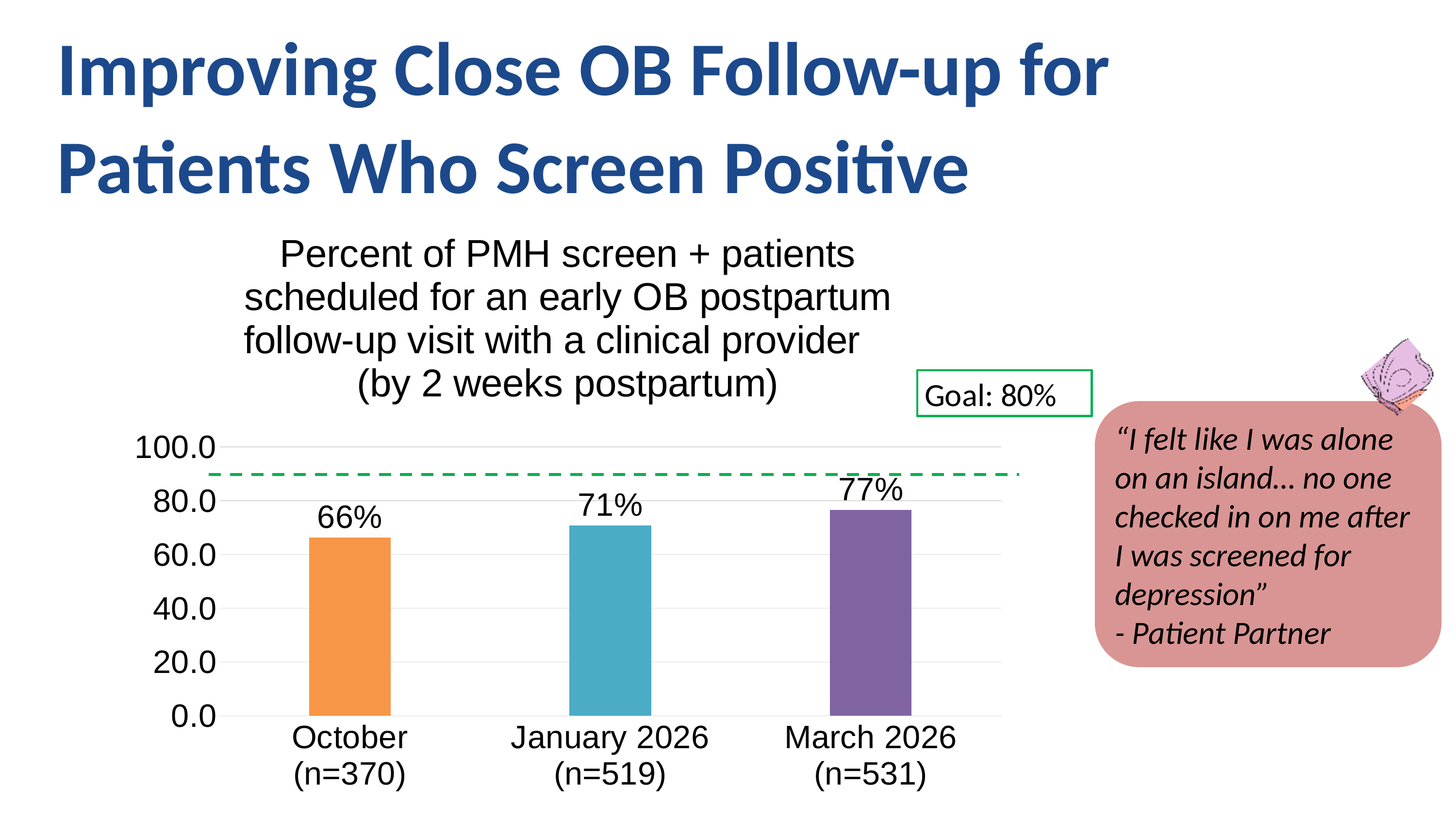
What is the value for October (n=370)? 66% Which category has the lowest value? October (n=370) Which is larger, the value for January 2026 or the value for March 2026? March 2026 Which category has the highest value? March 2026 (n=531) Do the values rise or fall from October to March 2026? rise Is the value for March 2026 greater or less than 80? less What is the value for January 2026 (n=519)? 71% What is the difference between the values for January 2026 and October? 5% How many categories are shown on the x axis? 3 What is the value for March 2026 (n=531)? 77% What is the difference between the values for March 2026 and October? 11% What kind of chart is shown on the slide? bar chart